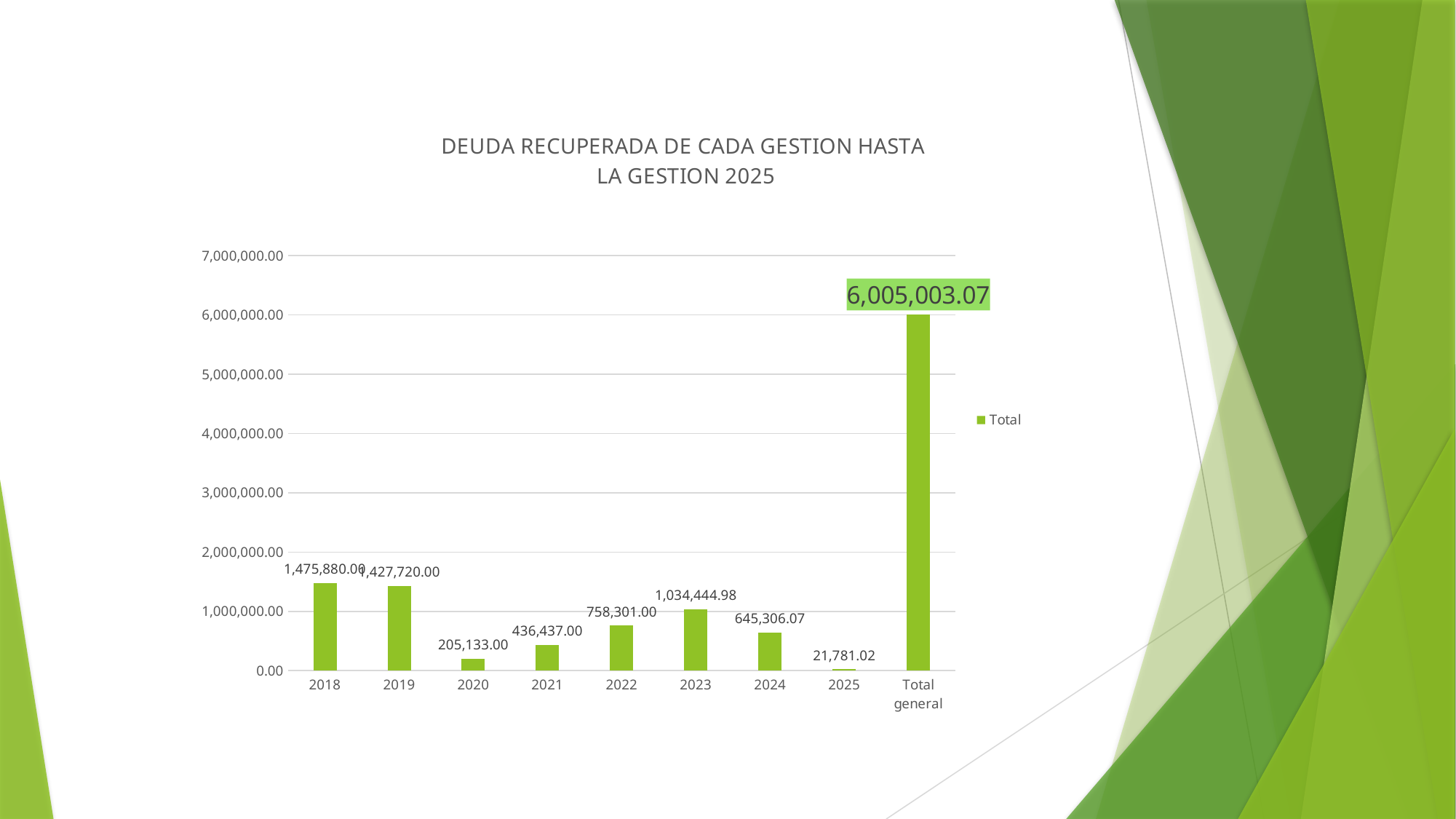
What is the value for 2025? 21,781.02 Which year has the lowest value? 2025 Which is larger, the value for 2022 or the value for 2024? 2022 What is the difference between the values for 2018 and 2019? 48,160.00 What is the value shown for Total general? 6,005,003.07 What is the value for 2018? 1,475,880.00 Is the value for 2021 greater or less than 1,000,000.00? less How many bars are plotted in the chart? 9 What series name does the legend list? Total What kind of chart is shown on the slide? bar chart Excluding the Total general bar, which year has the highest value? 2018 What is the value for 2023? 1,034,444.98